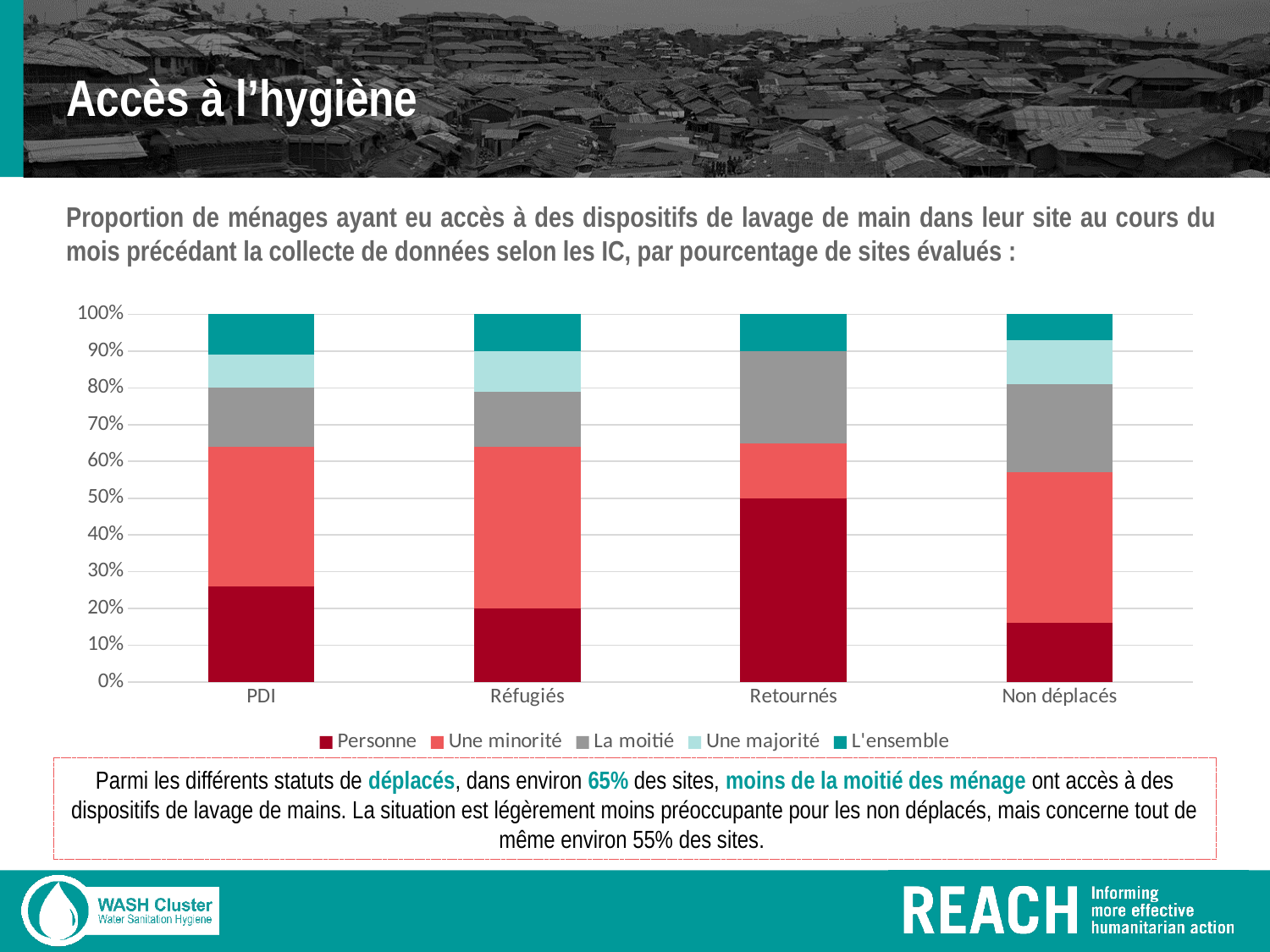
Is the 'Personne' value for Retournés greater or less than 40%? greater What is the label of the third category on the x axis? Retournés Which is larger, the 'Personne' value for Retournés or for Réfugiés? Retournés Is the 'Personne' value for Non déplacés greater or less than 20%? less How many categories are shown on the x axis of the chart? 4 What is the total of the stacked bar for PDI? 100% Which category has no visible 'Une majorité' segment? Retournés How many series does the chart legend list? 5 What is the first series listed in the chart legend? Personne Is the 'Personne' value for PDI greater or less than 30%? less What kind of chart is shown on the slide? Stacked bar chart Which category has the largest 'Personne' segment? Retournés